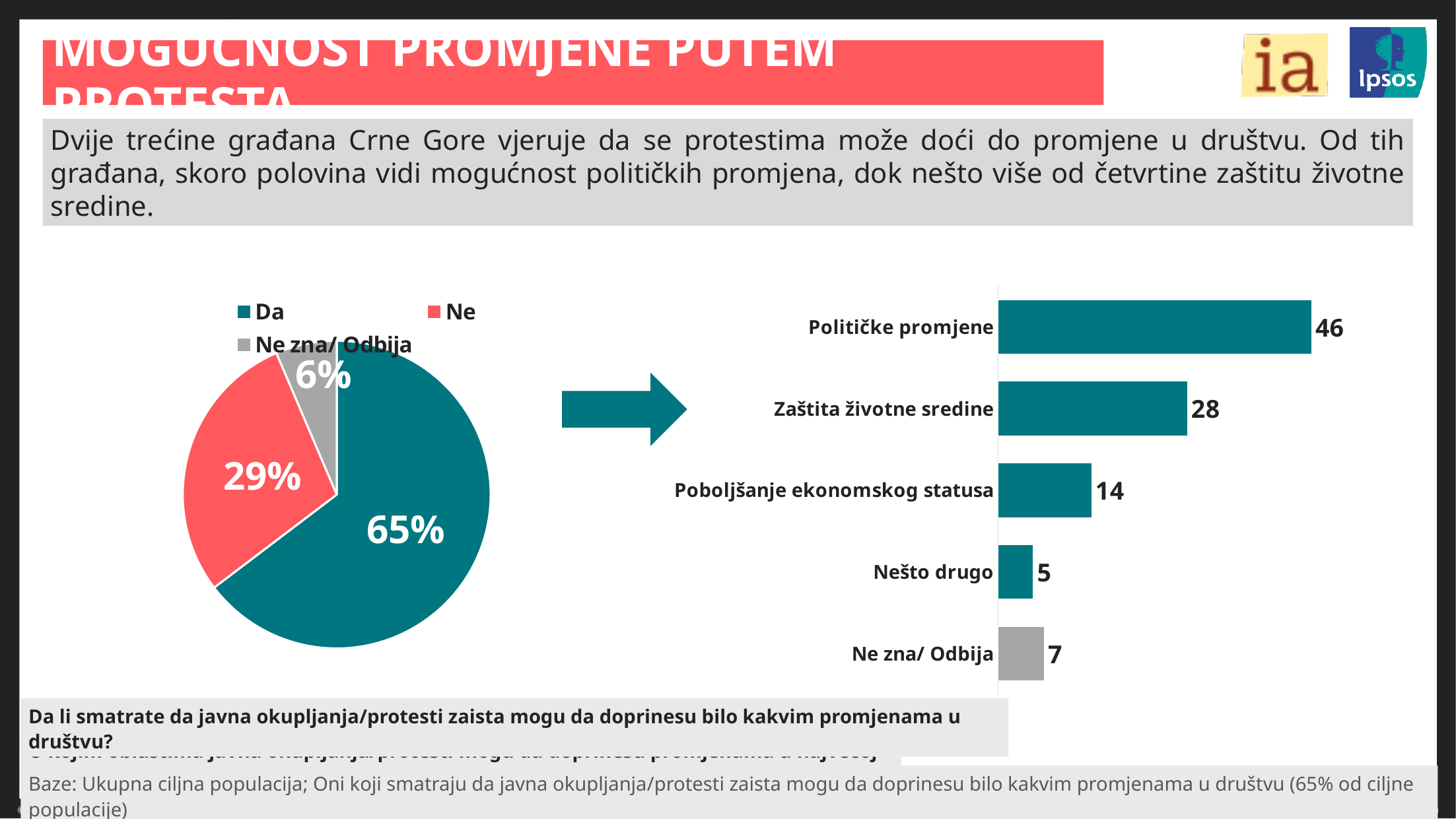
In the bar chart on the right, how many categories are shown? 5 In the bar chart on the right, what is the difference between "Političke promjene" and "Zaštita životne sredine"? 18 In the bar chart on the right, which category has the lowest value? Nešto drugo In the bar chart on the right, what is the value for "Zaštita životne sredine"? 28 In the pie chart on the left, what share of respondents answered "Ne"? 29% In the pie chart on the left, how many entries does the legend list? 3 In the pie chart on the left, what share of respondents answered "Da"? 65% What kind of chart is shown on the right side of the slide? Bar chart In the pie chart on the left, which answer has the largest slice? Da In the pie chart on the left, what share is labelled "Ne zna/ Odbija"? 6% In the bar chart on the right, what is the value for "Političke promjene"? 46 In the bar chart on the right, what is the value for "Poboljšanje ekonomskog statusa"? 14